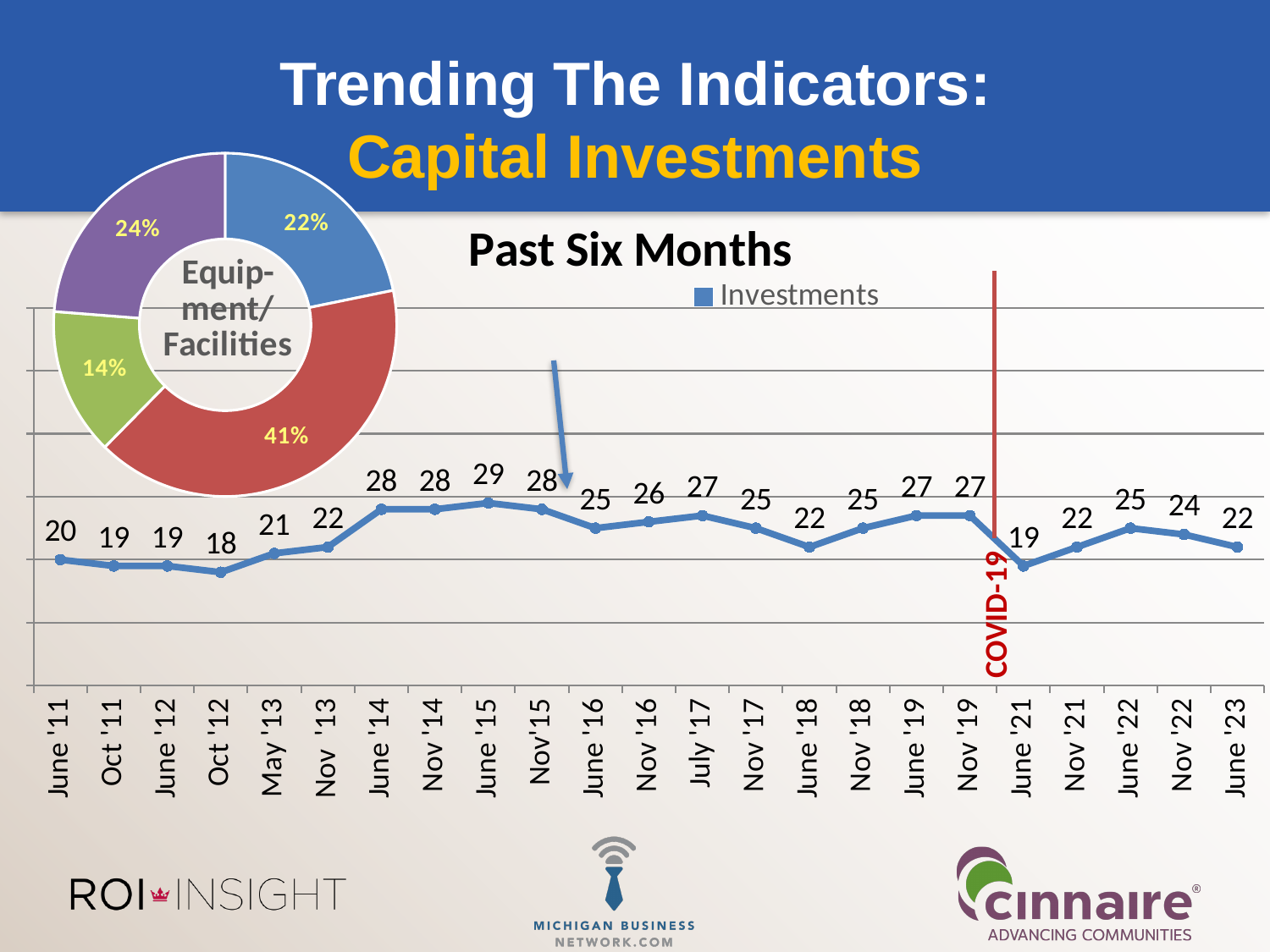
In the 'Past Six Months' line chart, which period has the highest value? June '15 In the 'Equipment/Facilities' doughnut chart, what is the percentage of the largest slice? 41% In the 'Past Six Months' line chart, what is the difference between the values for Nov '19 and June '21? 8 In the 'Past Six Months' line chart, do the values rise or fall from Oct '12 to June '14? Rise In the 'Past Six Months' line chart, what is the value for June '21? 19 How many series does the legend of the 'Past Six Months' chart list? 1 How many data points are plotted in the 'Past Six Months' line chart? 23 In the 'Past Six Months' line chart, which period has the lowest value? Oct '12 What kind of chart is the 'Past Six Months' chart? Line chart In the 'Past Six Months' line chart, which is larger, the value for June '14 or the value for June '18? June '14 How many slices does the 'Equipment/Facilities' doughnut chart have? 4 In the 'Past Six Months' line chart, what is the value for June '15? 29